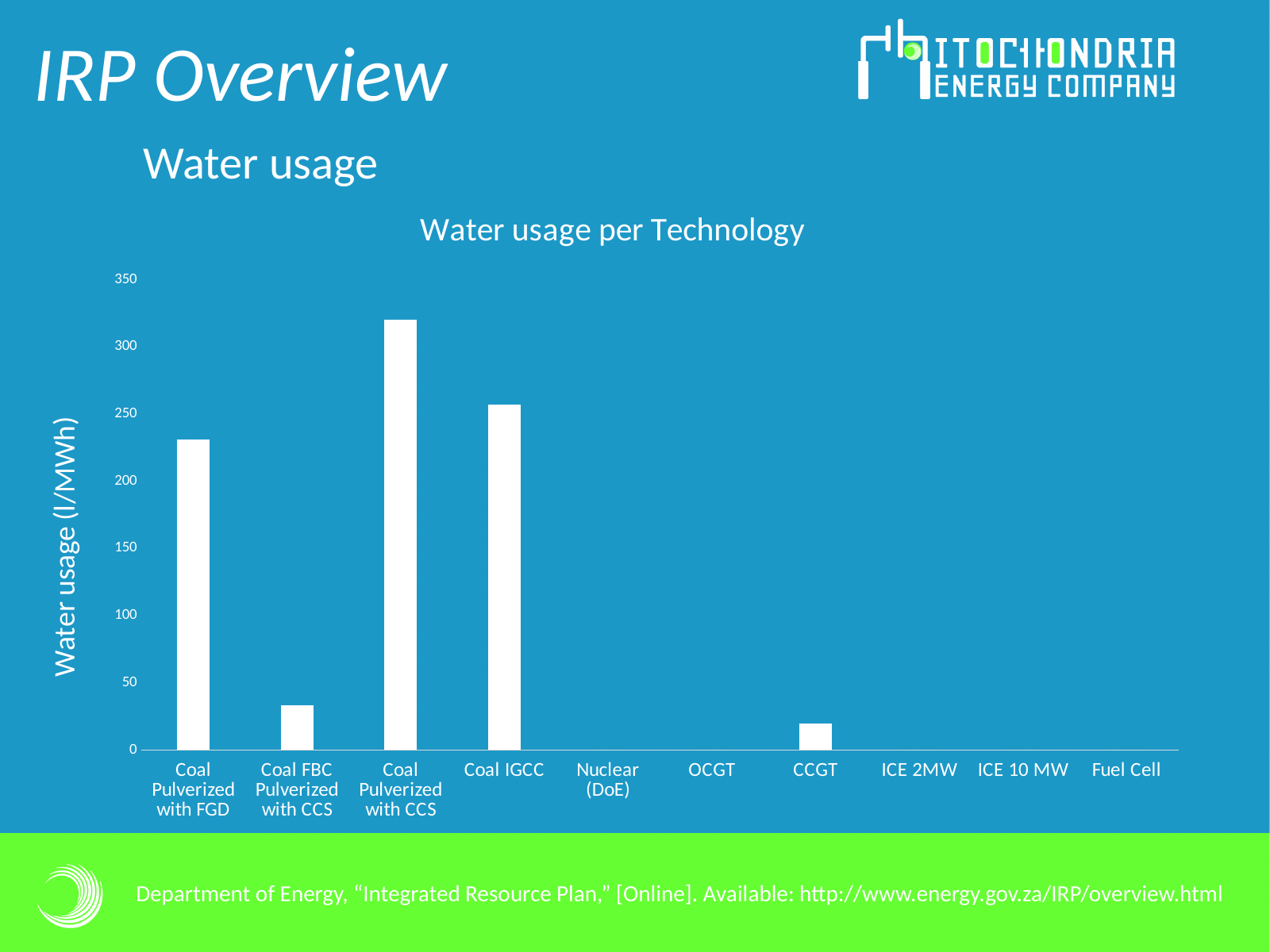
Is the water usage for Coal IGCC greater or less than 200? greater What is the label on the vertical axis of the chart? Water usage (l/MWh) How many technology categories are shown on the x axis of the chart? 10 Is the water usage for CCGT greater or less than 50? less What kind of chart is shown on the slide? Bar chart Is the water usage for Coal Pulverized with FGD greater or less than 200? greater What is the title of the chart? Water usage per Technology Which technology has the highest water usage in the chart? Coal Pulverized with CCS Which has higher water usage, Coal FBC Pulverized with CCS or CCGT? Coal FBC Pulverized with CCS Which has higher water usage, Coal IGCC or Coal Pulverized with FGD? Coal IGCC